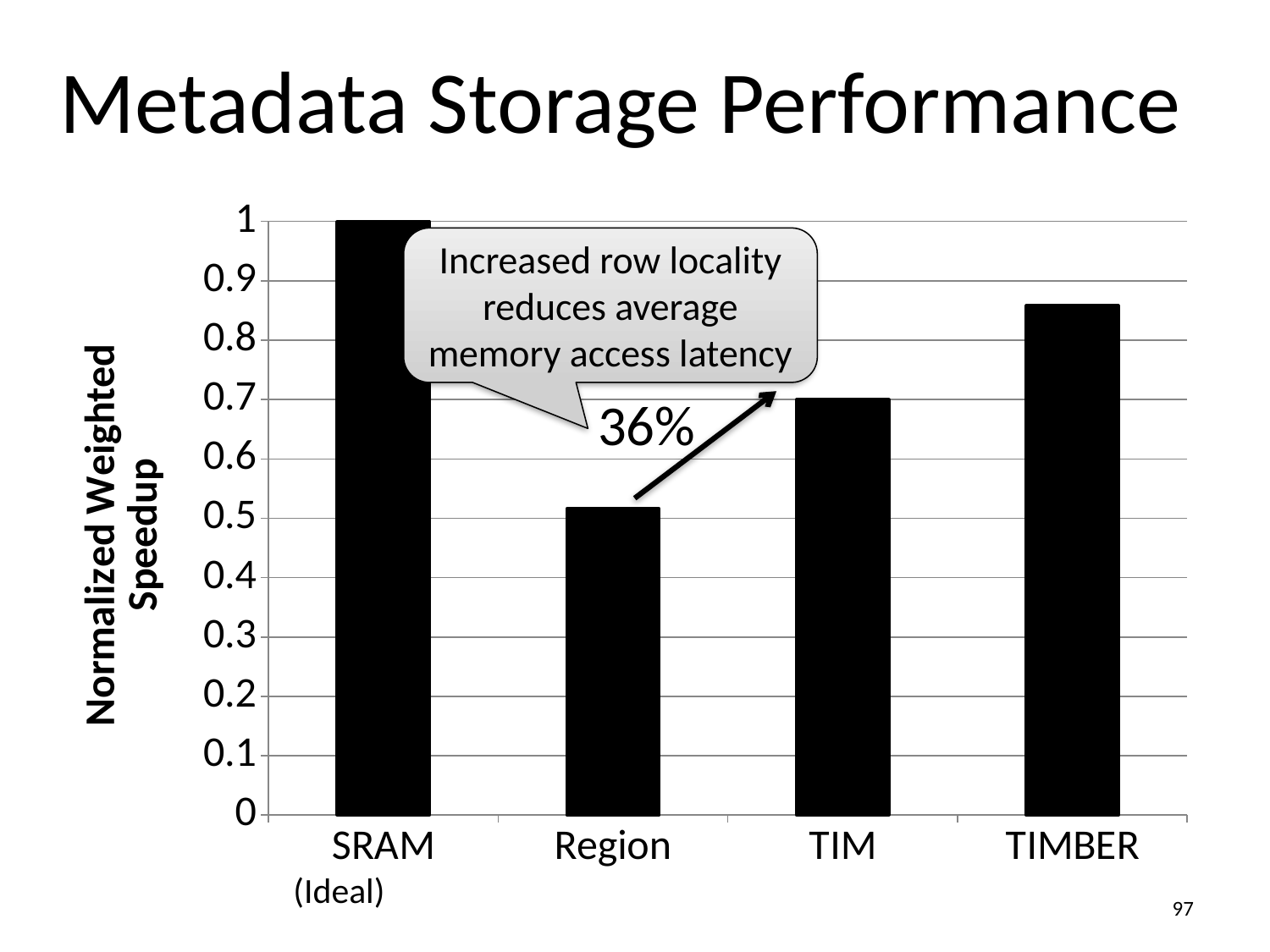
What percentage is written next to the arrow between the Region and TIM bars? 36% What is the normalized weighted speedup for SRAM (Ideal)? 1 How many categories are plotted on the x axis? 4 Which has a larger normalized weighted speedup, TIM or TIMBER? TIMBER Is the value for Region greater or less than 0.6? less Is the value for TIM greater or less than 0.6? greater Which has a larger normalized weighted speedup, Region or TIM? TIM What is the label of the y axis? Normalized Weighted Speedup Which category has the highest normalized weighted speedup? SRAM (Ideal) Is the value for TIMBER greater or less than 0.8? greater Which category has the lowest normalized weighted speedup? Region What kind of chart is shown on the slide? bar chart